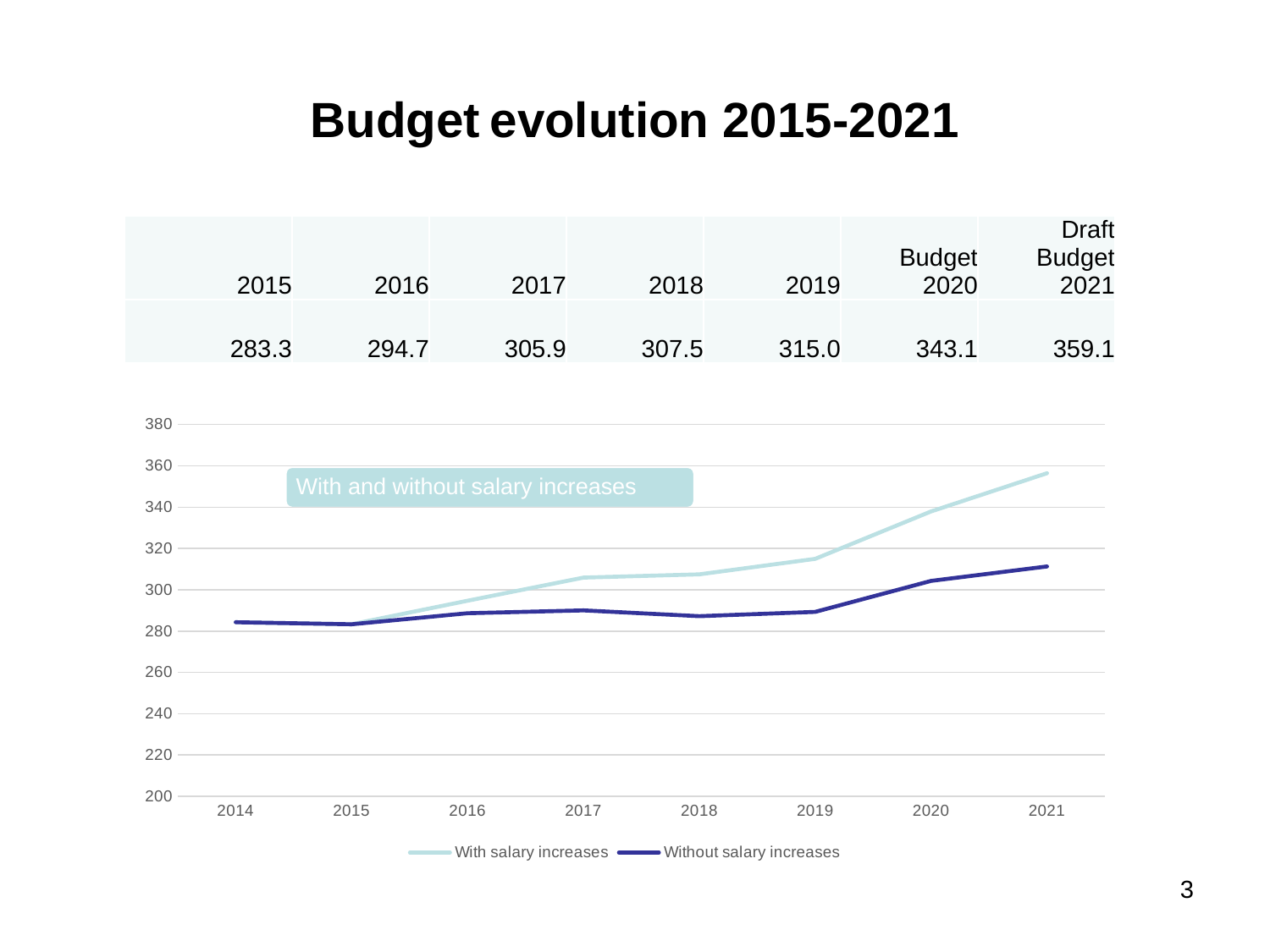
In 2021, which series has the larger value, 'With salary increases' or 'Without salary increases'? With salary increases What kind of chart is shown on the slide? line chart How many series does the chart's legend list? 2 Is the value for 'With salary increases' in 2020 greater or less than 320? greater Does the 'With salary increases' line rise or fall from 2014 to 2021? rise Is the value for 'Without salary increases' in 2017 greater or less than 300? less According to the table above the chart, what is the budget value for 2019? 315.0 Is the value for 'Without salary increases' in 2021 greater or less than 300? greater How many years are plotted along the x axis of the chart? 8 According to the table above the chart, what is the Draft Budget 2021 value? 359.1 What is the title of the slide containing the chart? Budget evolution 2015-2021